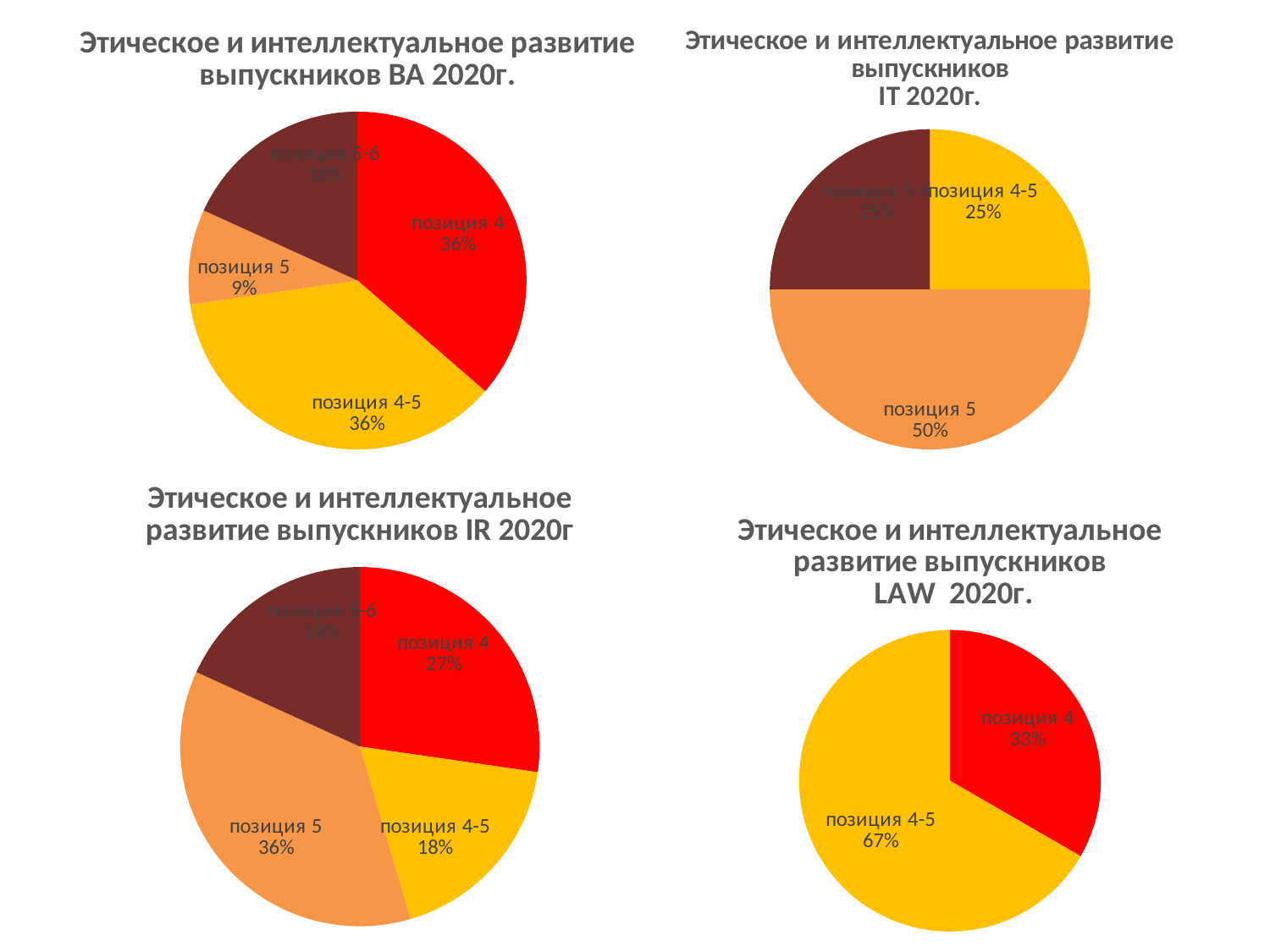
In the BA 2020 chart, what share does позиция 5 have? 9% How many slices does the IR 2020 chart have? 4 In the IR 2020 chart, what share does позиция 4 have? 27% In the BA 2020 chart, what share does позиция 5-6 have? 18% In the IR 2020 chart, what is the difference between the shares of позиция 5 and позиция 4-5? 18% In the IT 2020 chart, which category has the largest share? позиция 5 In the IT 2020 chart, what share does позиция 4-5 have? 25% In the IR 2020 chart, which category has the largest share? позиция 5 How many slices does the LAW 2020 chart have? 2 In the LAW 2020 chart, what share does позиция 4-5 have? 67% What type of chart is the BA 2020 chart? pie chart In the LAW 2020 chart, which is larger, позиция 4 or позиция 4-5? позиция 4-5